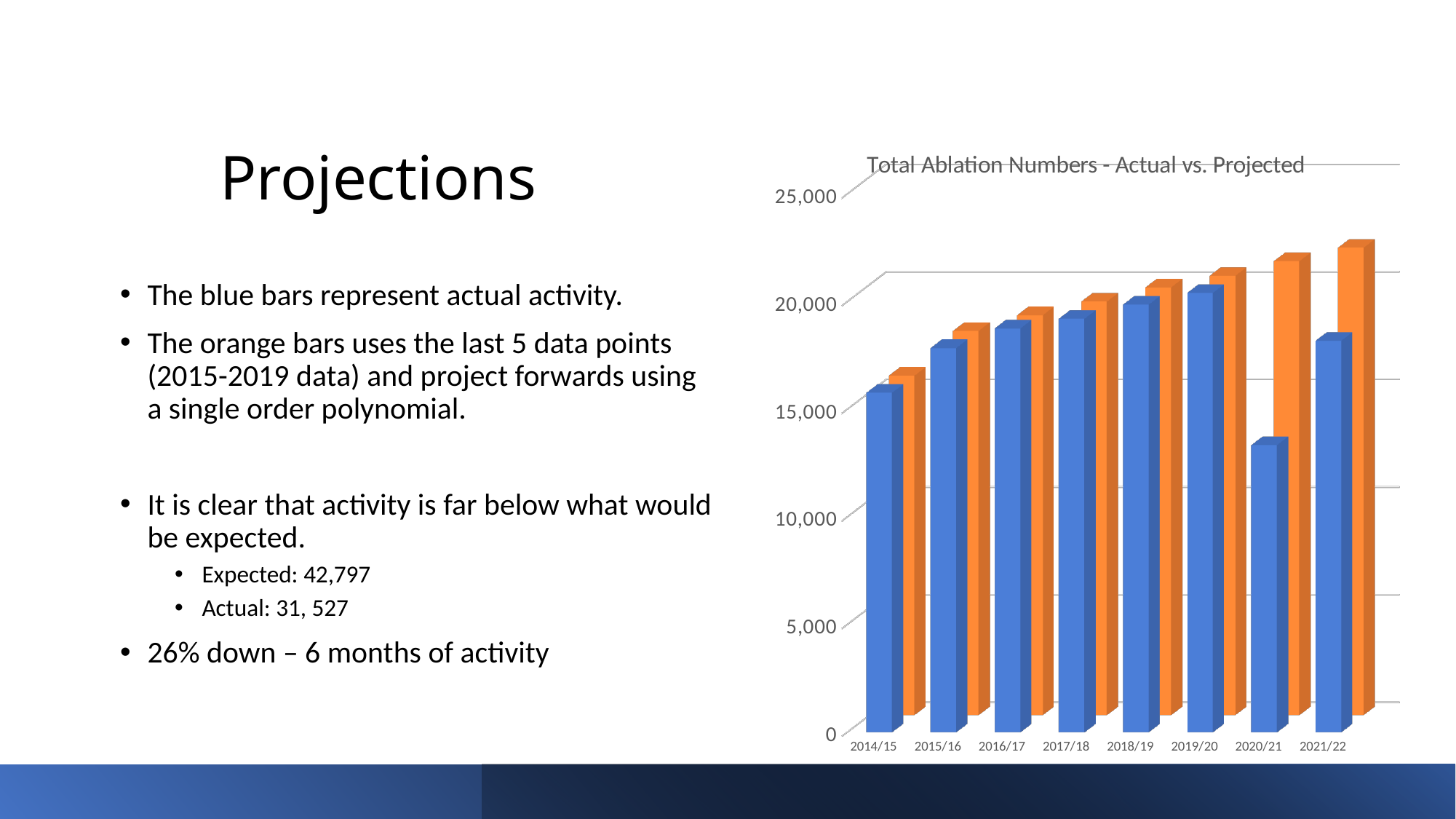
Which year has the lowest blue (actual) bar? 2020/21 For 2020/21, which bar is larger, the blue (actual) or the orange (projected)? orange (projected) Which year has the lowest orange (projected) bar? 2014/15 Do the orange (projected) bars rise or fall from 2014/15 to 2021/22? rise Is the blue (actual) value for 2021/22 greater or less than 20,000? less How many years are shown on the x axis of the chart? 8 How many bars are plotted for each year in the chart? 2 Is the orange (projected) value for 2021/22 greater or less than 20,000? greater Is the blue (actual) value for 2020/21 greater or less than 15,000? less What is the title of the chart? Total Ablation Numbers - Actual vs. Projected Which year has the highest orange (projected) bar? 2021/22 What kind of chart is shown on the slide? bar chart